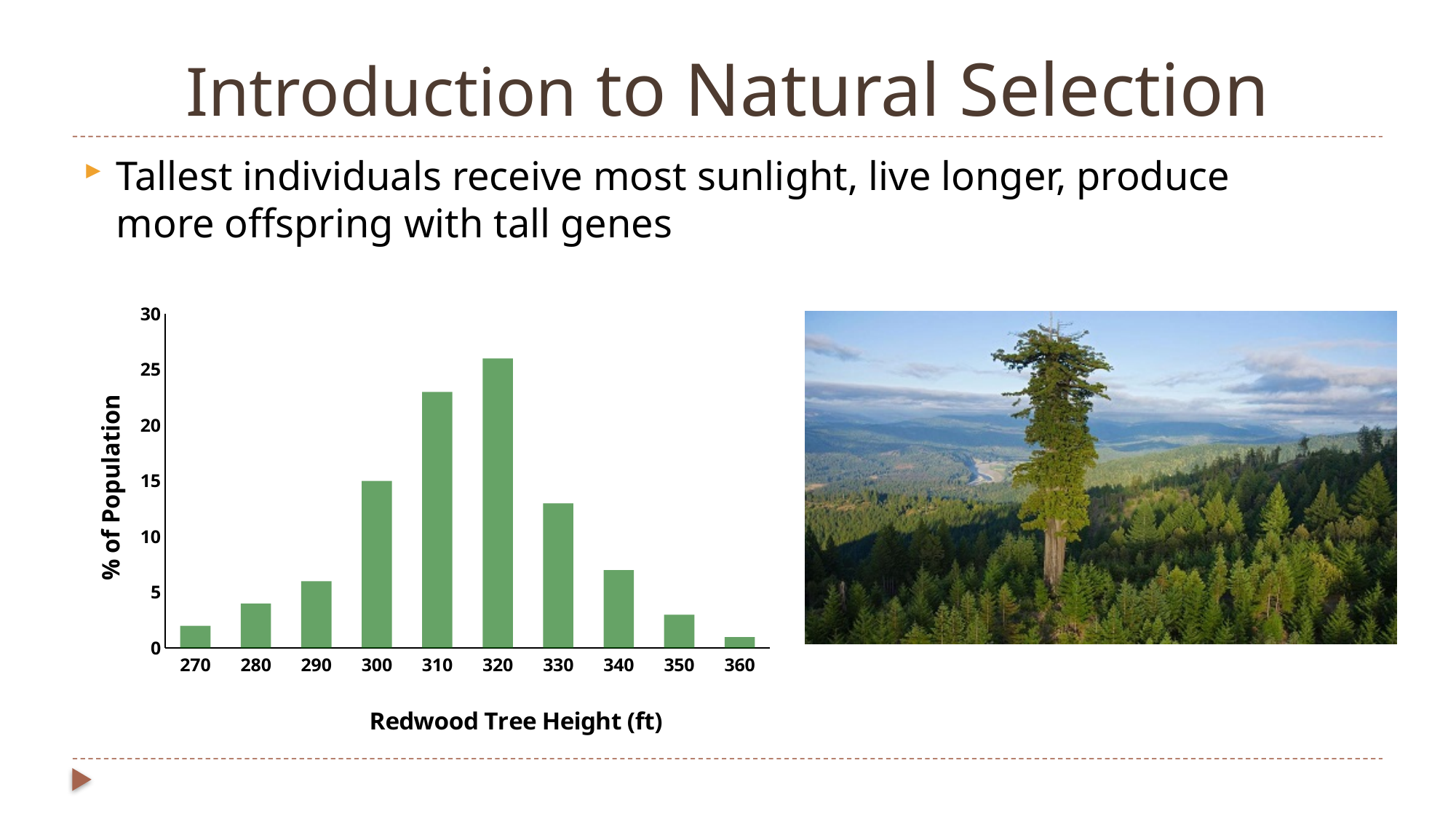
How many tree height categories are shown on the x axis of the chart? 10 Is the % of population for 290 ft trees greater or less than 10? less Which redwood tree height has the highest % of population? 320 Which has a larger % of population, 310 ft trees or 330 ft trees? 310 What kind of chart is shown on the slide? bar chart Which redwood tree height has the lowest % of population? 360 Is the % of population for 310 ft trees greater or less than 20? greater Do the values rise or fall as tree height increases from 270 ft to 320 ft? rise Is the % of population for 320 ft trees greater or less than 25? greater What is the % of population for redwood trees of height 300 ft? 15 What is the title of the x axis of the chart? Redwood Tree Height (ft)